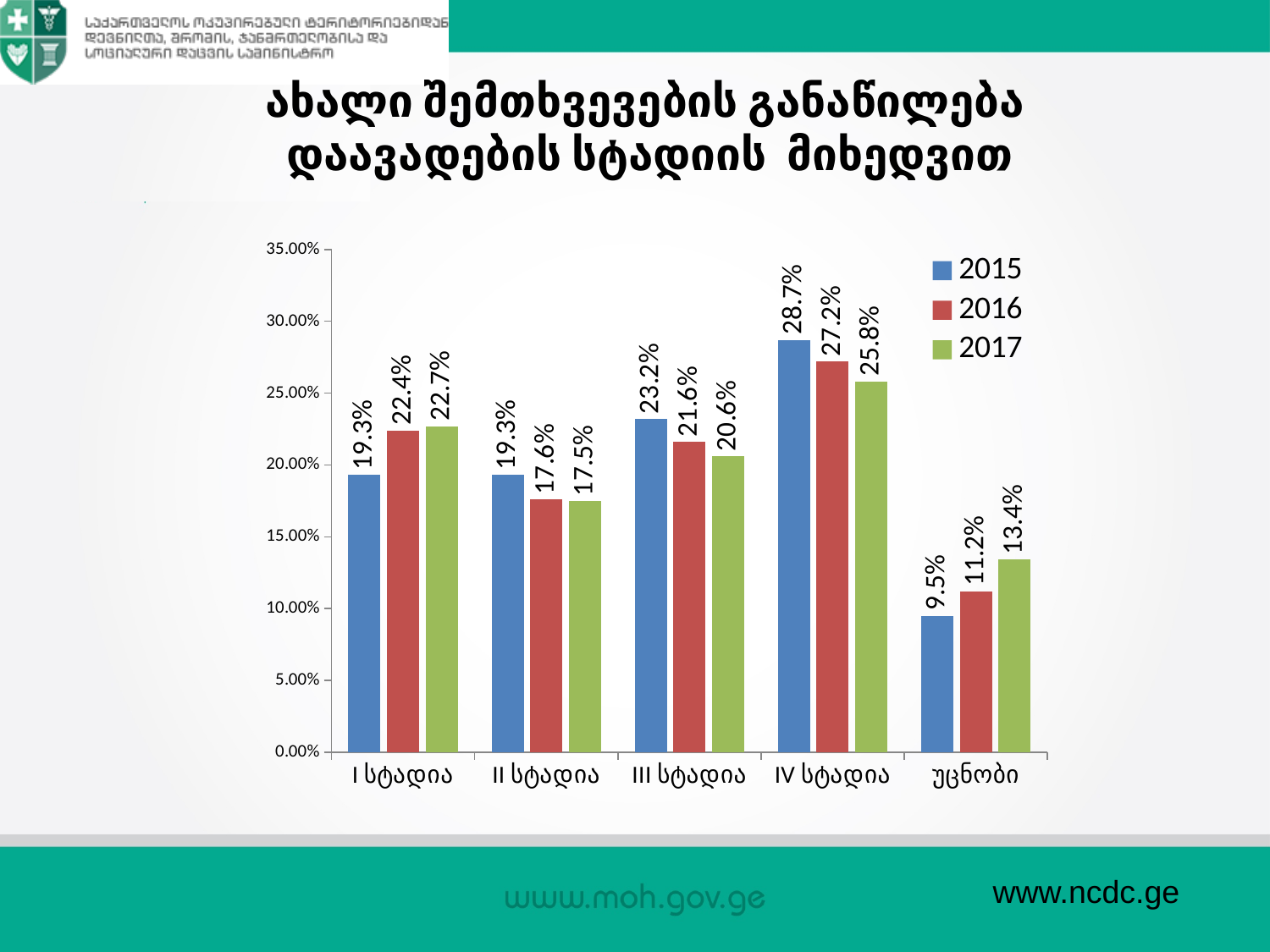
In the III სტადია category, which series has the larger value, 2015 or 2017? 2015 How many series does the legend list? 3 Which category has the highest value for the 2015 series? IV სტადია What is the value for 2016 in the IV სტადია category? 27.2% What is the difference between the 2015 and 2017 values in the IV სტადია category? 2.9% What kind of chart is shown on the slide? bar chart Is the value for 2016 in the უცნობი category greater or less than 15.00%? less Across the years 2015, 2016 and 2017, do the values in the უცნობი category rise or fall? rise What is the value for 2015 in the I სტადია category? 19.3% How many categories are shown on the x axis? 5 What is the value for 2017 in the უცნობი category? 13.4% Which category has the lowest value for the 2017 series? უცნობი